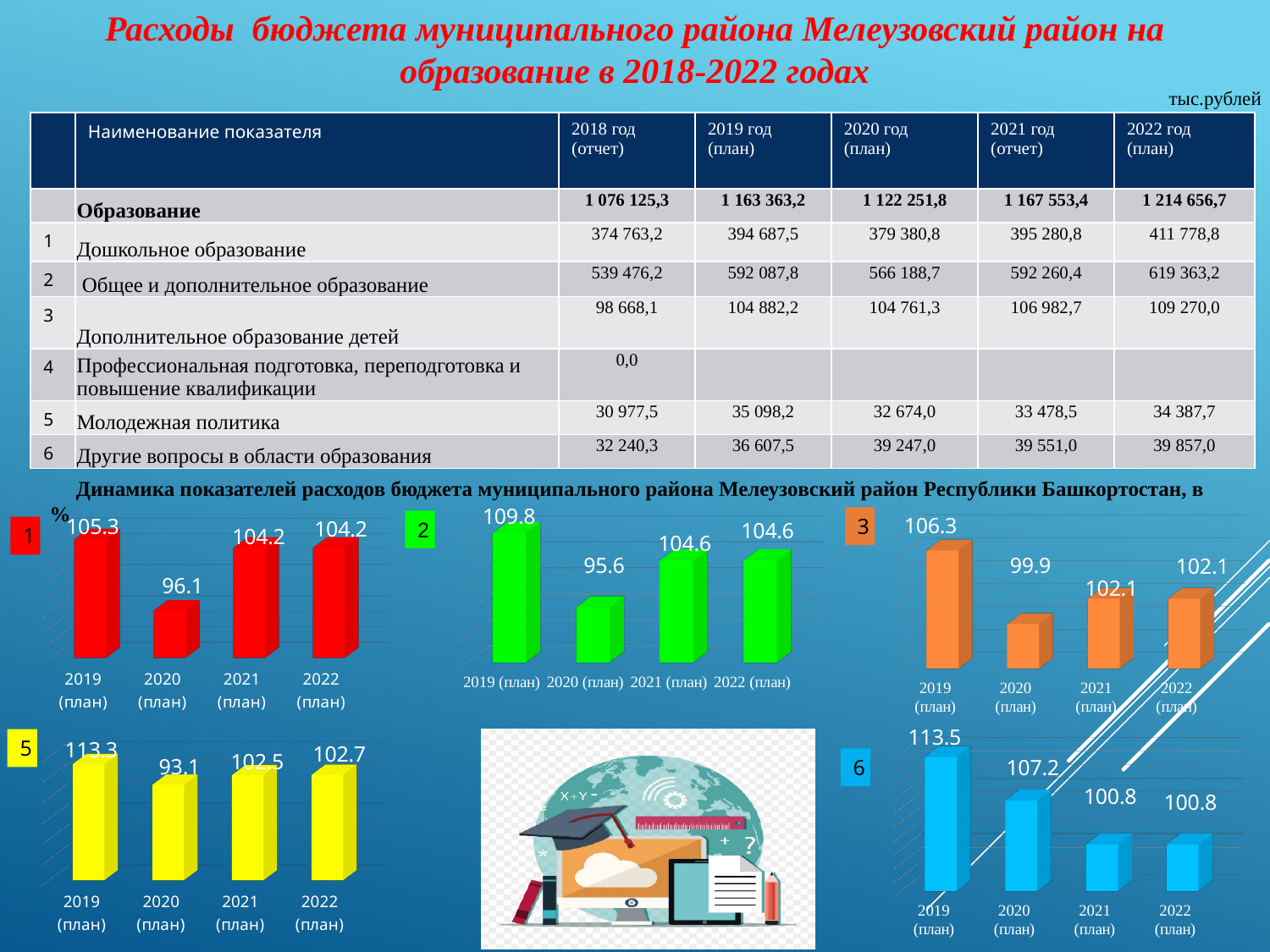
On the red bar chart labelled 1, what is the value for 2020 (план)? 96.1 On the yellow bar chart labelled 5, what is the value for 2019 (план)? 113.3 On the orange bar chart labelled 3, what is the difference between the 2019 (план) and 2020 (план) values? 6.4 On the green bar chart labelled 2, what is the value for 2020 (план)? 95.6 On the yellow bar chart labelled 5, which is larger, the value for 2021 (план) or 2022 (план)? 2022 (план) What kind of chart is the chart labelled 6 at the bottom right? bar chart On the blue bar chart labelled 6, do the values rise or fall from 2019 (план) to 2022 (план)? fall On the orange bar chart labelled 3, which year has the lowest value? 2020 (план) How many bars does the red bar chart labelled 1 have? 4 On the green bar chart labelled 2, which year has the highest value? 2019 (план) On the blue bar chart labelled 6, what is the value for 2020 (план)? 107.2 On the red bar chart labelled 1, what is the difference between the 2019 (план) and 2020 (план) values? 9.2